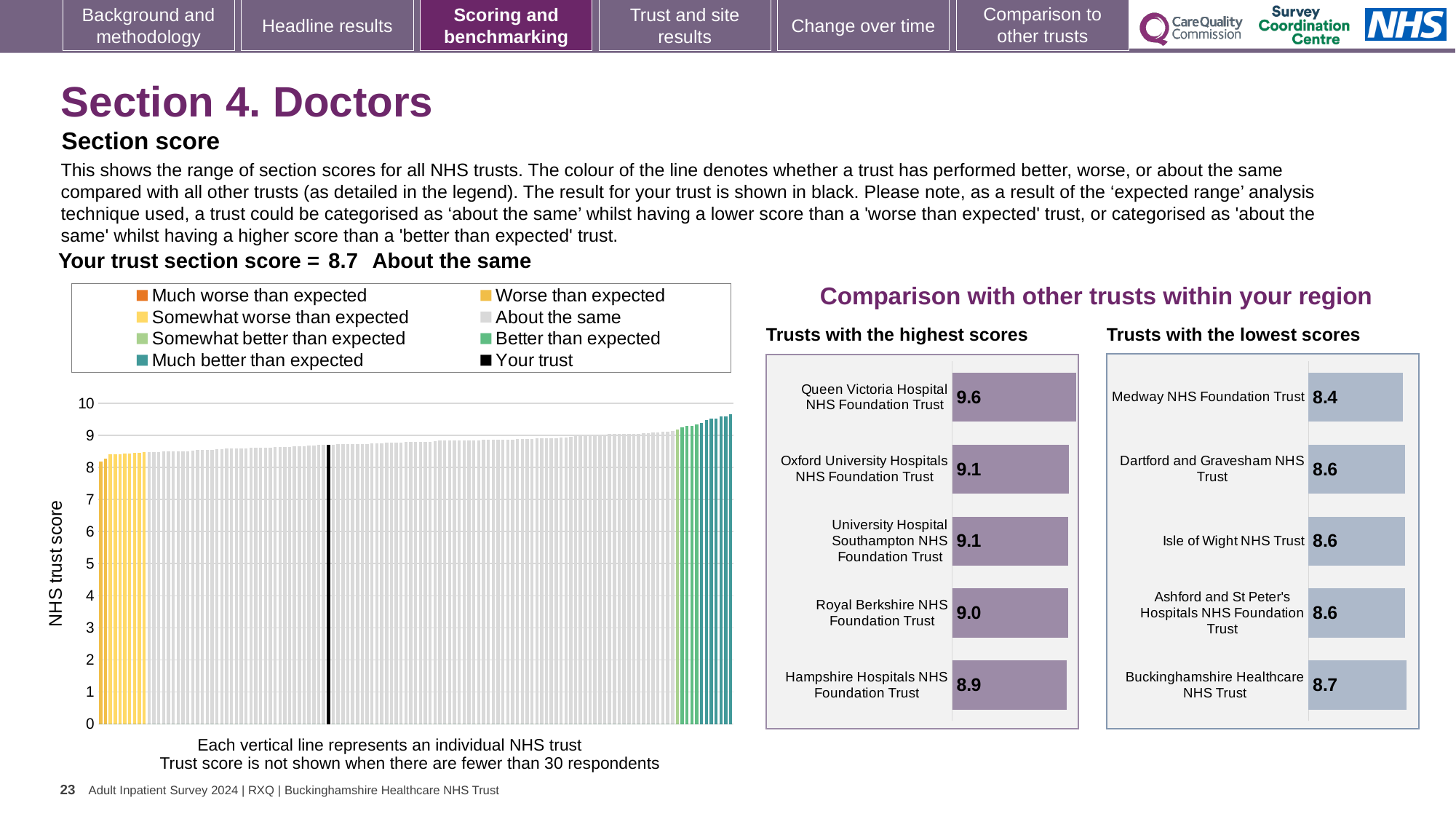
In the 'Trusts with the lowest scores' chart, which has the larger score: Medway NHS Foundation Trust or Buckinghamshire Healthcare NHS Trust? Buckinghamshire Healthcare NHS Trust In the main NHS trust score chart on the left, do the values rise or fall from left to right? rise In the 'Trusts with the lowest scores' chart, which trust has the lowest score? Medway NHS Foundation Trust How many trusts are shown in the 'Trusts with the highest scores' chart? 5 In the 'Trusts with the highest scores' chart, which trust has the highest score? Queen Victoria Hospital NHS Foundation Trust In the main NHS trust score chart on the left, is the value of the tallest bar greater or less than 9? greater In the 'Trusts with the highest scores' chart, what is the difference between the scores of Queen Victoria Hospital NHS Foundation Trust and Hampshire Hospitals NHS Foundation Trust? 0.7 What kind of chart is the main NHS trust score chart on the left? bar chart In the 'Trusts with the lowest scores' chart, what is the score for Medway NHS Foundation Trust? 8.4 In the 'Trusts with the lowest scores' chart, what is the score for Buckinghamshire Healthcare NHS Trust? 8.7 In the 'Trusts with the highest scores' chart, what is the score for Queen Victoria Hospital NHS Foundation Trust? 9.6 How many entries does the legend of the main NHS trust score chart list? 8